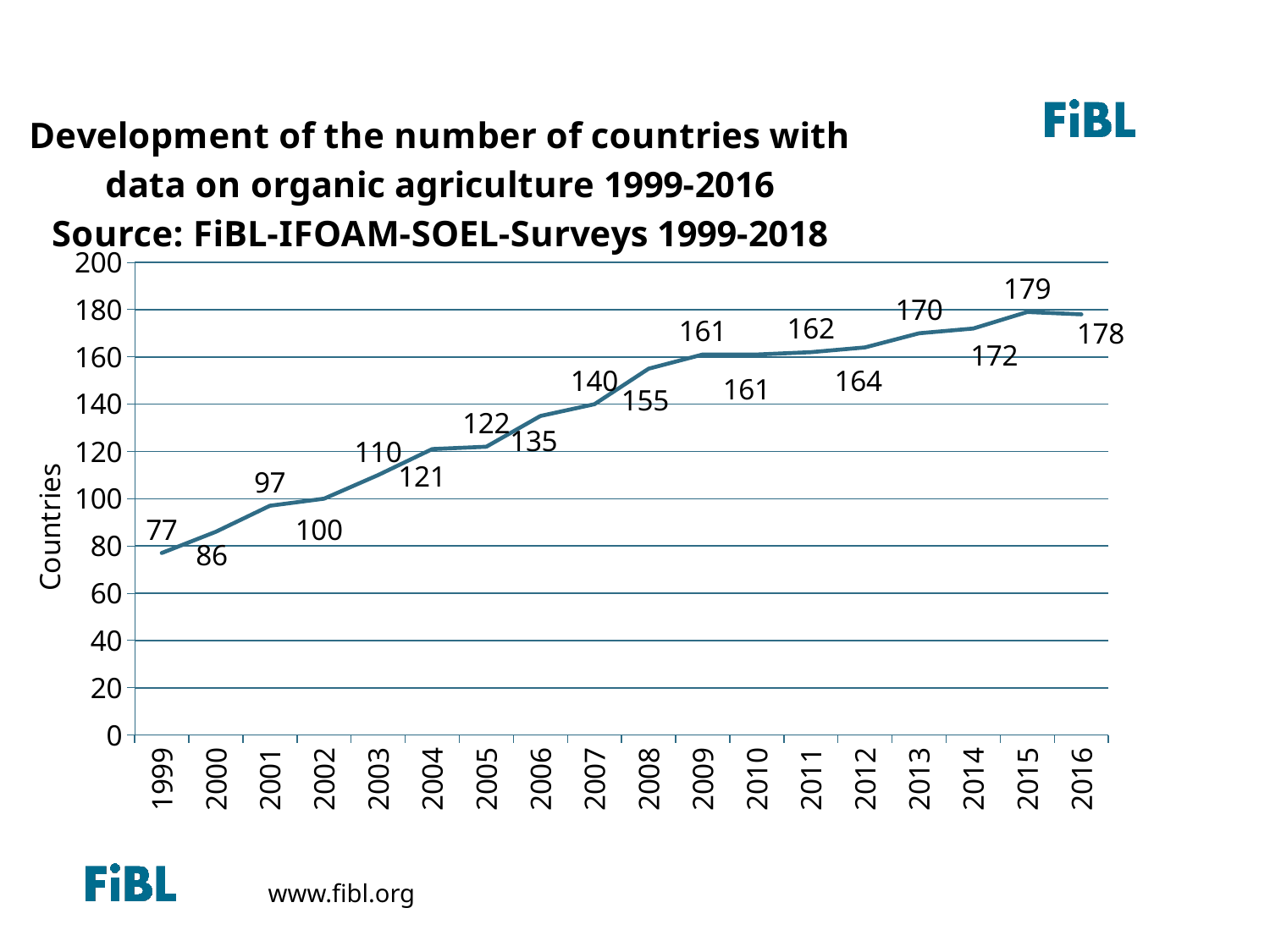
What is the difference between the number of countries in 2016 and in 1999? 101 How many years are plotted on the x axis? 18 Which year has the lowest number of countries? 1999 What kind of chart is shown on the slide? line chart What is the number of countries shown for 2008? 155 Is the value for 2003 greater or less than 100? greater Which year has the highest number of countries? 2015 What is the difference between the number of countries in 2015 and in 2014? 7 What is the label of the y axis? Countries What is the number of countries shown for 2016? 178 Which year has more countries, 2006 or 2007? 2007 What is the number of countries with data on organic agriculture in 1999? 77